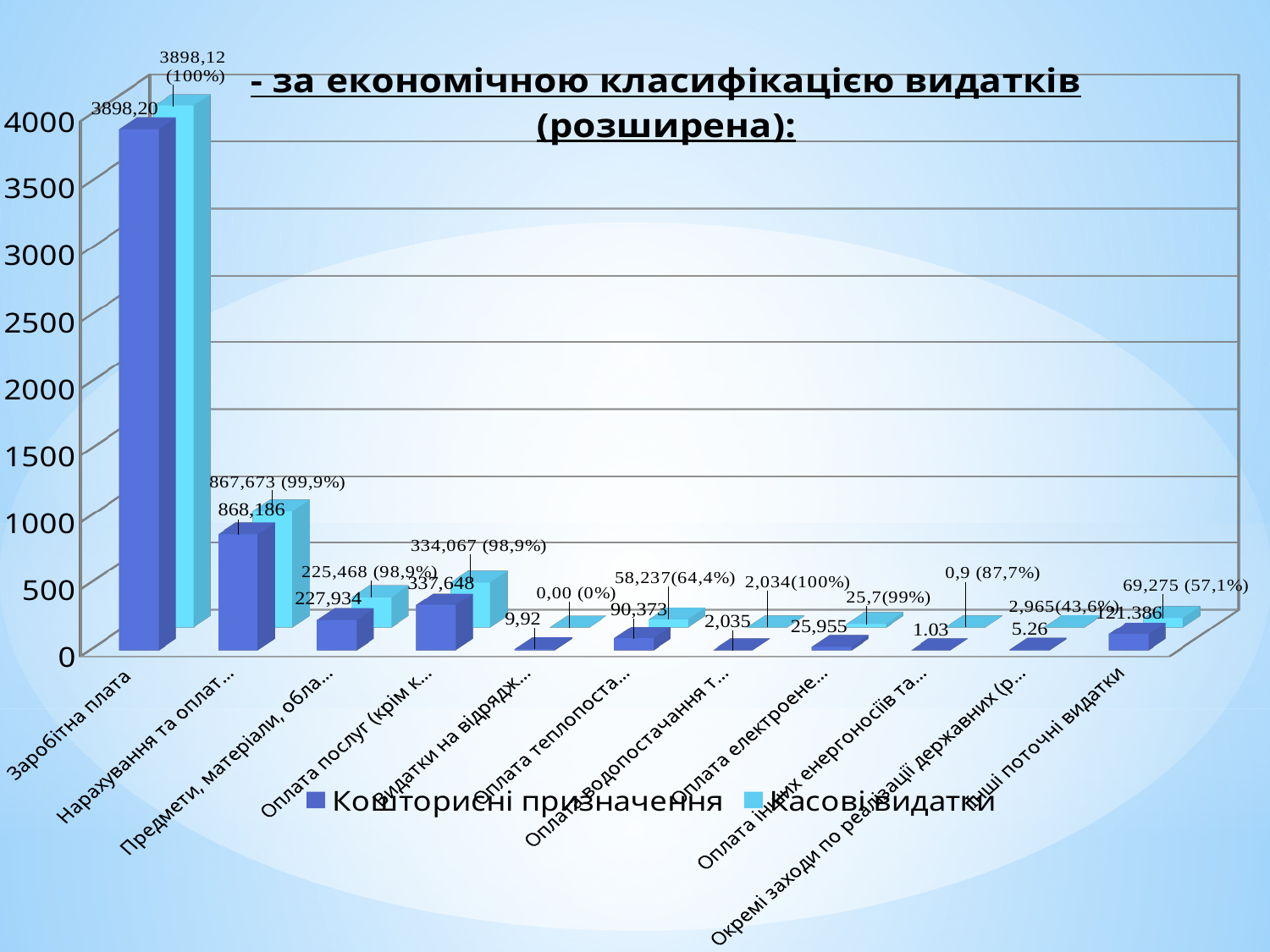
What is the value of Кошторисні призначення for Заробітна плата? 3898,20 How many categories are shown on the x axis? 11 What type of chart is shown on the slide? Bar chart What is the difference between Кошторисні призначення (90,373) and Касові видатки (58,237) for Оплата теплопоста...? 32,136 What is the data label for Касові видатки for Інші поточні видатки? 69,275 (57,1%) Which category has the highest value for Кошторисні призначення? Заробітна плата What are the two series named in the legend? Кошторисні призначення and Касові видатки What is the value of Кошторисні призначення for Оплата теплопоста...? 90,373 For Кошторисні призначення, which is larger: Оплата послуг (крім к... or Предмети, матеріали, обла...? Оплата послуг (крім к... Which category has the lowest value for Касові видатки? Видатки на відрядж... What is the data label for Касові видатки for Заробітна плата? 3898,12 (100%) How many series does the legend list? 2